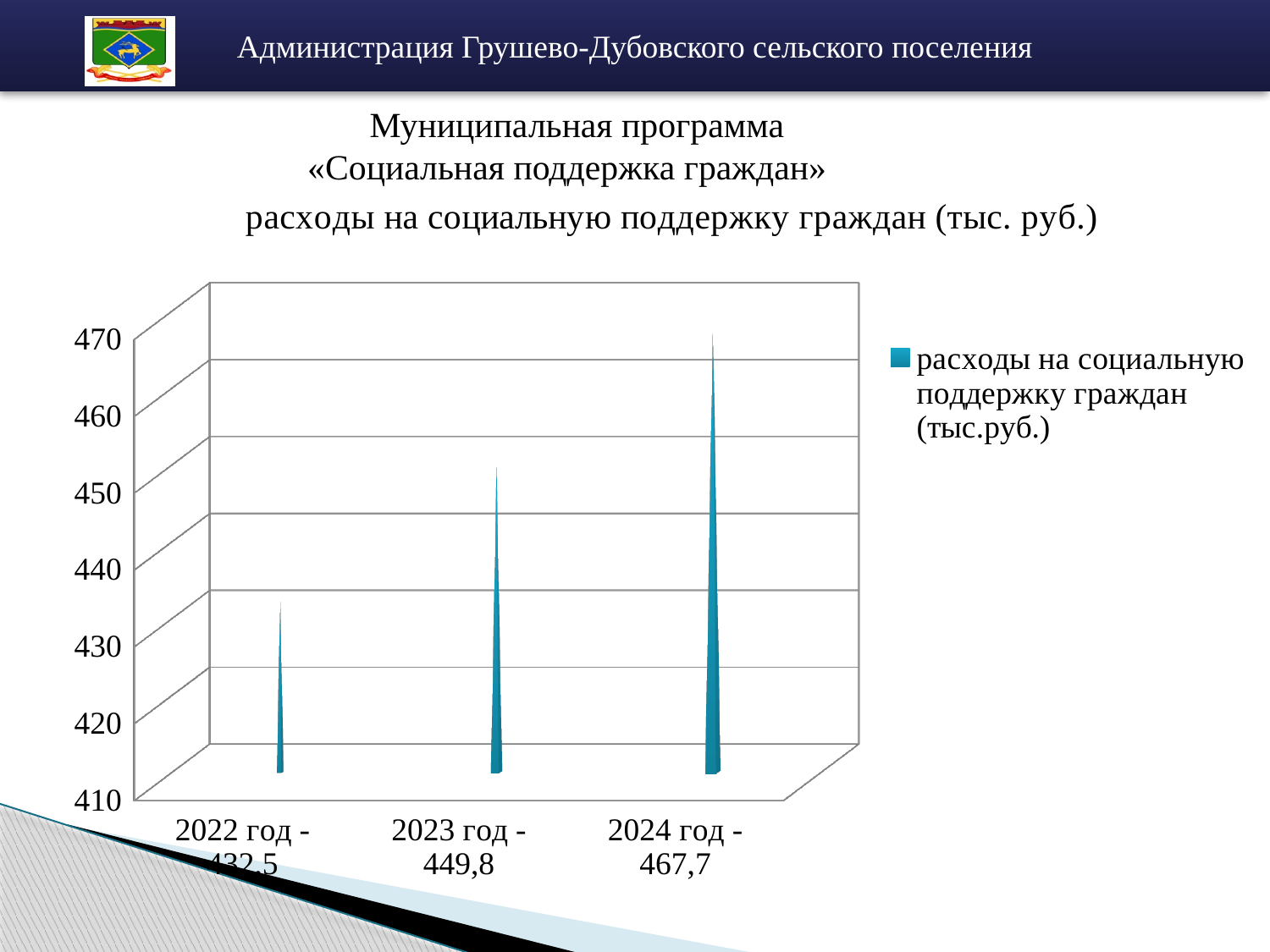
What is the difference between the values for 2024 год and 2023 год? 17,9 Is the value for 2022 год greater or less than 440? less Do the values rise or fall from 2022 to 2024? rise How many series does the legend list? 1 Which is larger, the value for 2023 год or the value for 2024 год? 2024 год Is the value for 2024 год greater or less than 460? greater What kind of chart is shown on the slide? bar chart How many years are shown on the chart? 3 Which year has the highest expenditure on social support? 2024 год What is the value for 2024 год? 467,7 What is the value for 2023 год? 449,8 Which year has the lowest expenditure on social support? 2022 год